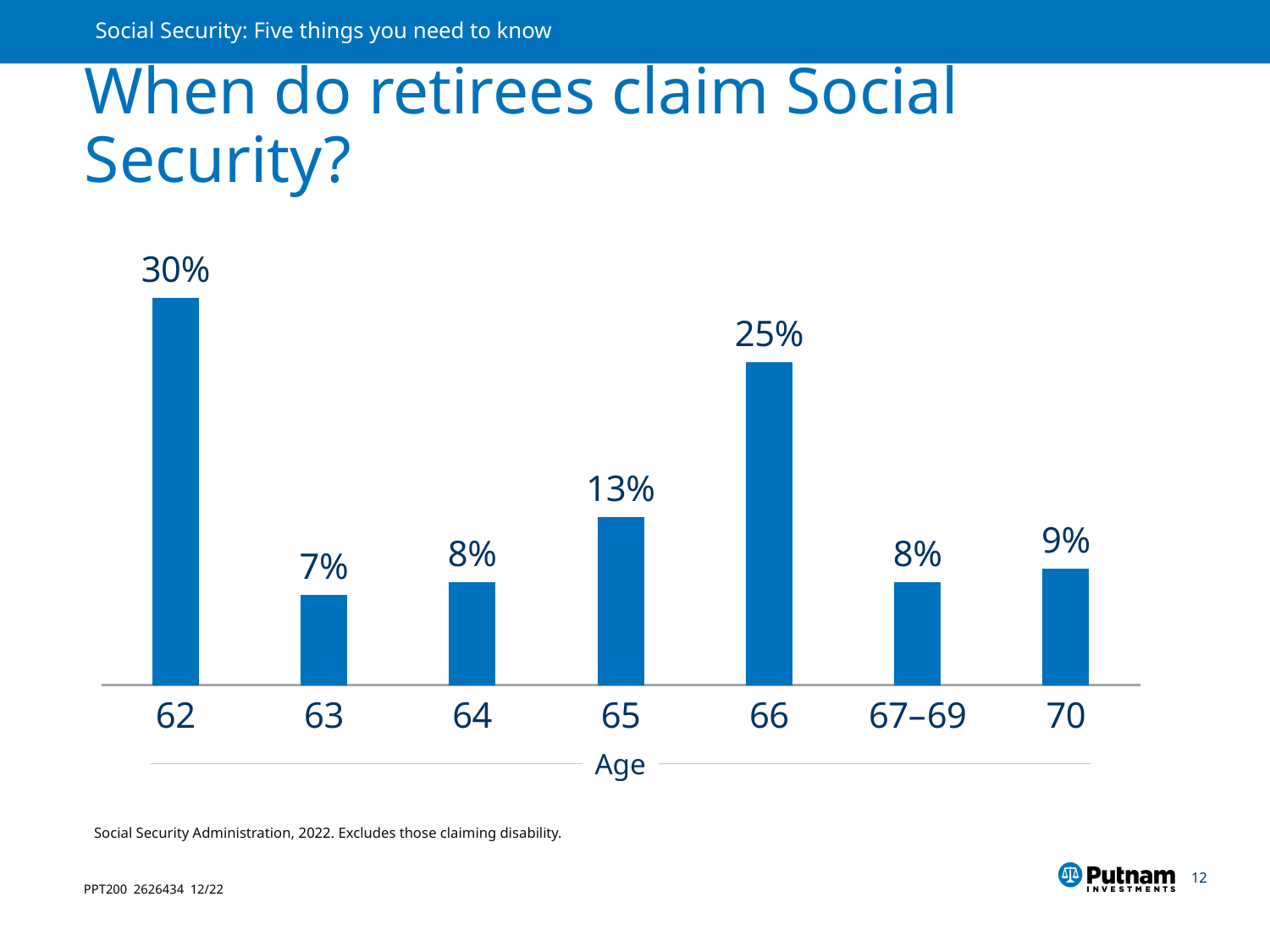
What is the difference between the percentage claiming at age 62 and at age 66? 5% Which is larger, the value for age 64 or the value for age 70? 70 What percentage of retirees claim Social Security at age 66? 25% How many age categories are shown on the x axis? 7 What is the difference between the percentage claiming at age 65 and at age 70? 4% At which age do the most retirees claim Social Security? 62 What percentage of retirees claim Social Security at age 62? 30% What kind of chart is shown on the slide? Bar chart What is the label of the x axis? Age What is the value shown for ages 67–69? 8% What is the value shown for age 65? 13% At which age do the fewest retirees claim Social Security? 63